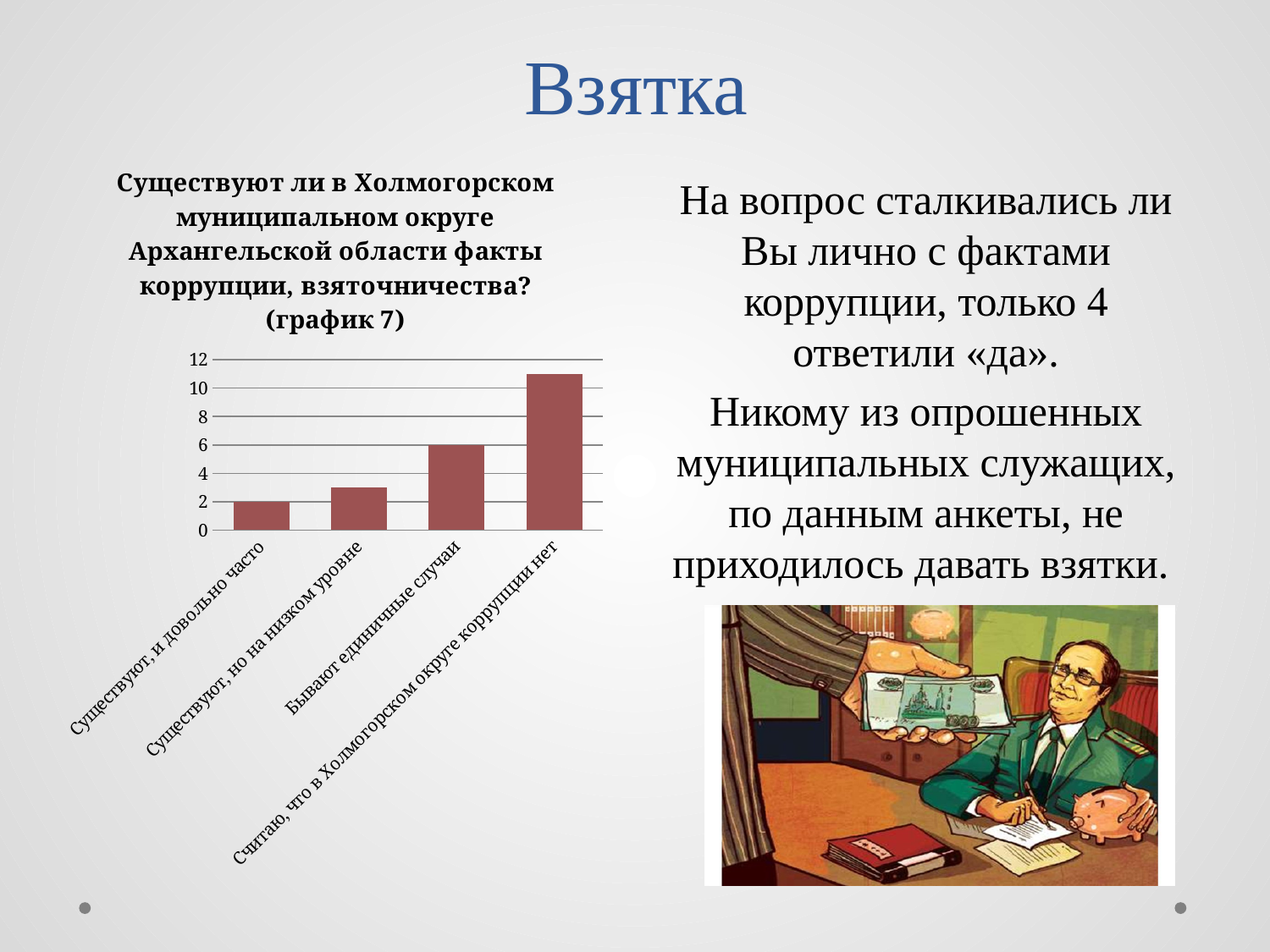
How many categories are shown on the x axis of the chart? 4 What is the value for "Бывают единичные случаи"? 6 Which is larger: the value for "Бывают единичные случаи" or the value for "Существуют, но на низком уровне"? Бывают единичные случаи What is the difference between the values for "Бывают единичные случаи" and "Существуют, и довольно часто"? 4 Is the value for "Существуют, но на низком уровне" greater or less than 4? less Which category has the highest bar in the chart? Считаю, что в Холмогорском округе коррупции нет What is the highest tick value shown on the vertical axis of the chart? 12 Is the value for "Считаю, что в Холмогорском округе коррупции нет" greater or less than 10? greater What is the value for "Существуют, и довольно часто"? 2 Do the bar values rise or fall from left to right along the x axis? rise What kind of chart is shown on the slide? bar chart Which category has the lowest bar in the chart? Существуют, и довольно часто